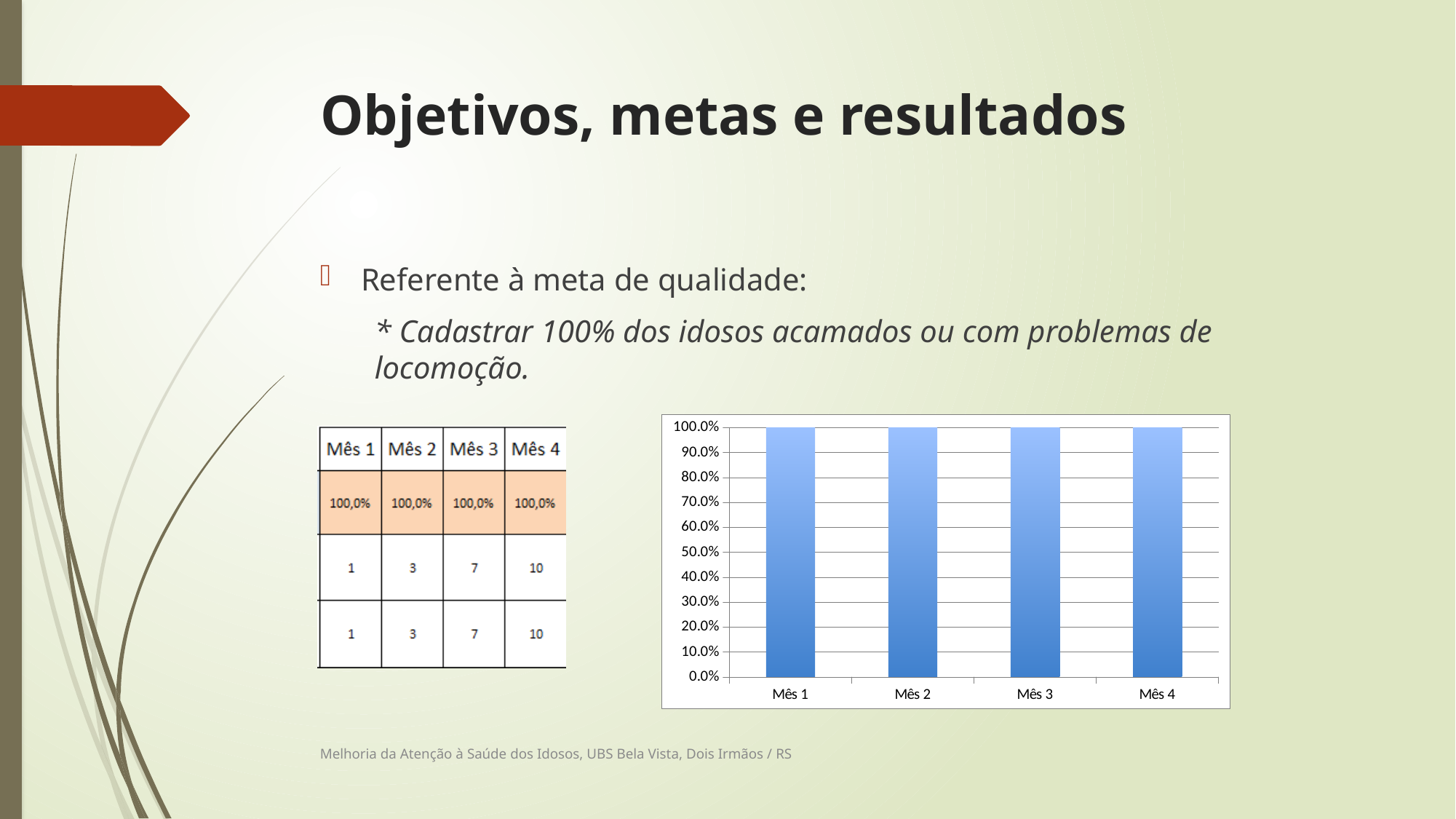
What kind of chart is shown on the slide? bar chart What colour are the bars in the chart? blue Is the value for Mês 2 greater or less than 50.0%? greater Is the value for Mês 4 greater or less than 90.0%? greater Do the values rise, fall, or stay flat from Mês 1 to Mês 4? stay flat What is the value for Mês 1 in the chart? 100.0% What is the value for Mês 4 in the chart? 100.0% What is the value for Mês 3 in the chart? 100.0% What is the value for Mês 2 in the chart? 100.0% What is the difference between the values for Mês 1 and Mês 4? 0.0% What is the label of the first category on the x axis? Mês 1 How many categories are plotted on the x axis of the chart? 4